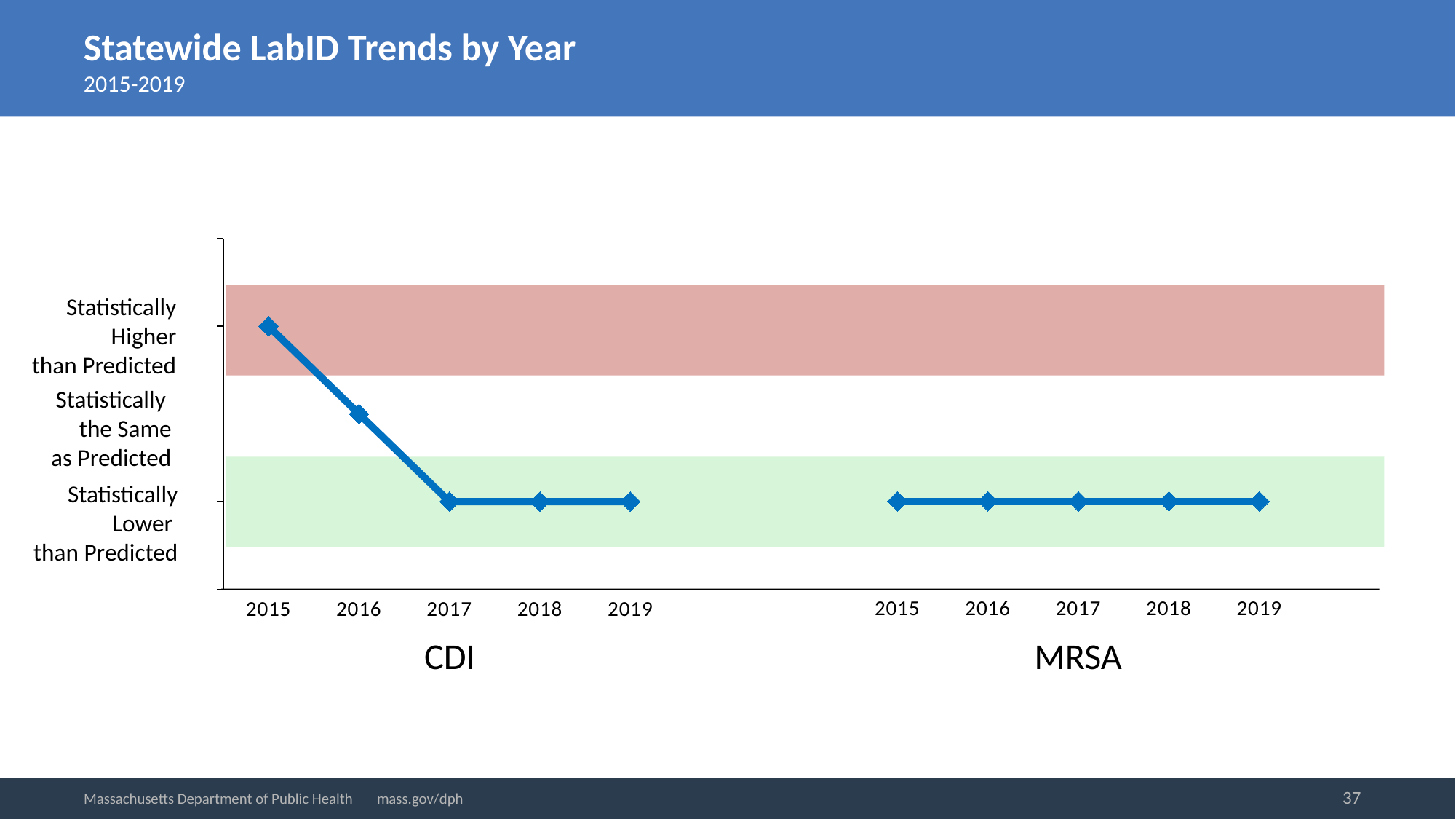
For CDI, what is the statistical category for 2017? Statistically Lower than Predicted How many years are plotted for CDI? 5 How many years are plotted for MRSA? 5 Does the CDI line rise or fall from 2015 to 2017? fall For CDI, what is the statistical category for 2016? Statistically the Same as Predicted What kind of chart is shown on the slide? line chart What is the title of the slide containing the chart? Statewide LabID Trends by Year Which year has the highest point for CDI? 2015 For MRSA, what is the statistical category for 2015? Statistically Lower than Predicted For CDI, what is the statistical category for 2015? Statistically Higher than Predicted For MRSA, what is the statistical category for 2019? Statistically Lower than Predicted Does the MRSA line rise, fall, or stay flat from 2015 to 2019? stay flat